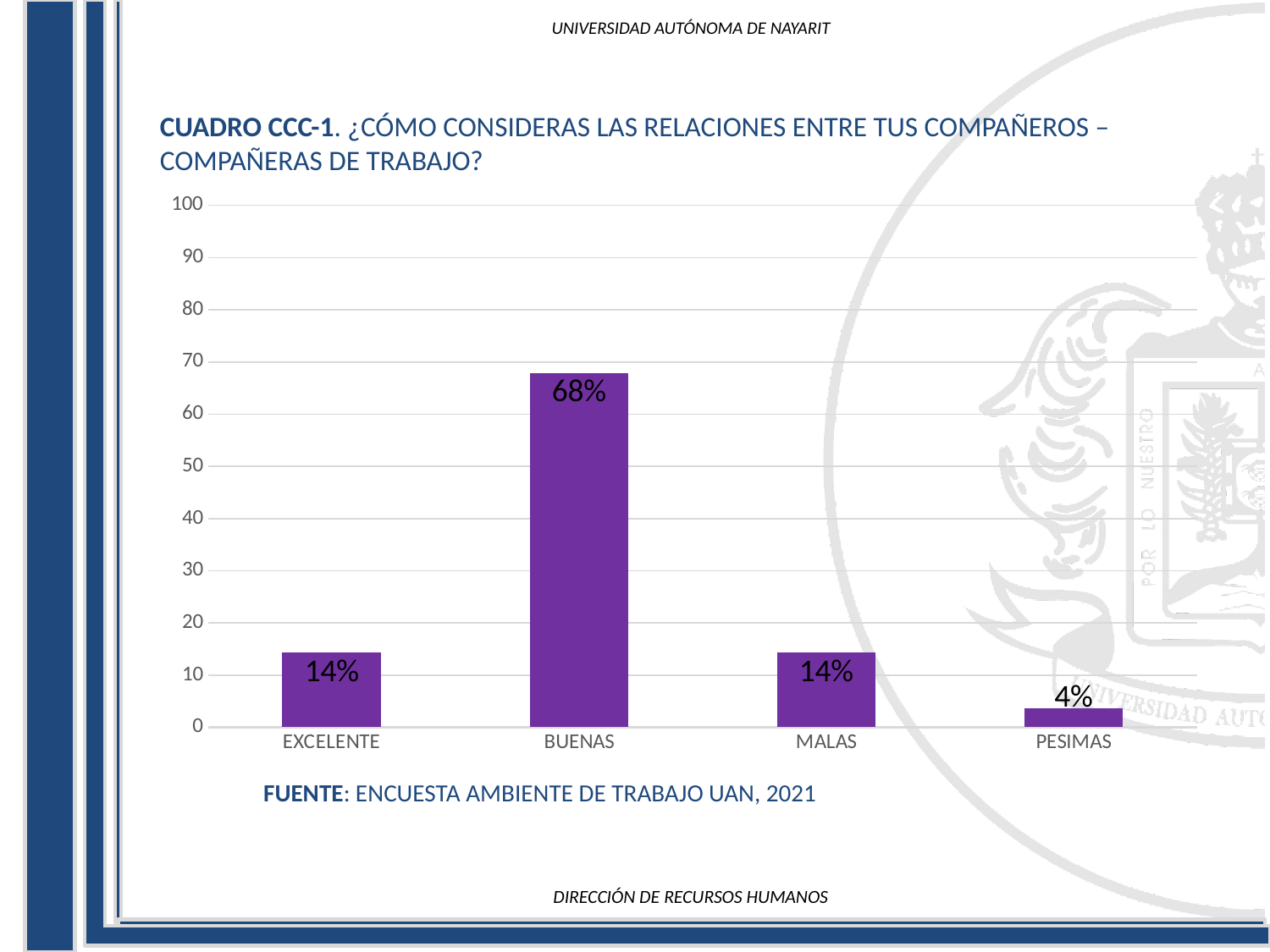
What kind of chart is shown on the slide? bar chart How many categories are shown on the x axis? 4 Is the value for BUENAS greater or less than 60? greater What is the value for EXCELENTE? 14% Which category has the lowest value? PESIMAS What is the highest value shown on the y axis? 100 What is the value for BUENAS? 68% What is the source cited below the chart? ENCUESTA AMBIENTE DE TRABAJO UAN, 2021 What is the difference between the values for BUENAS and MALAS? 54% What is the value for PESIMAS? 4% Which is larger, the value for MALAS or the value for PESIMAS? MALAS Which category has the highest value? BUENAS